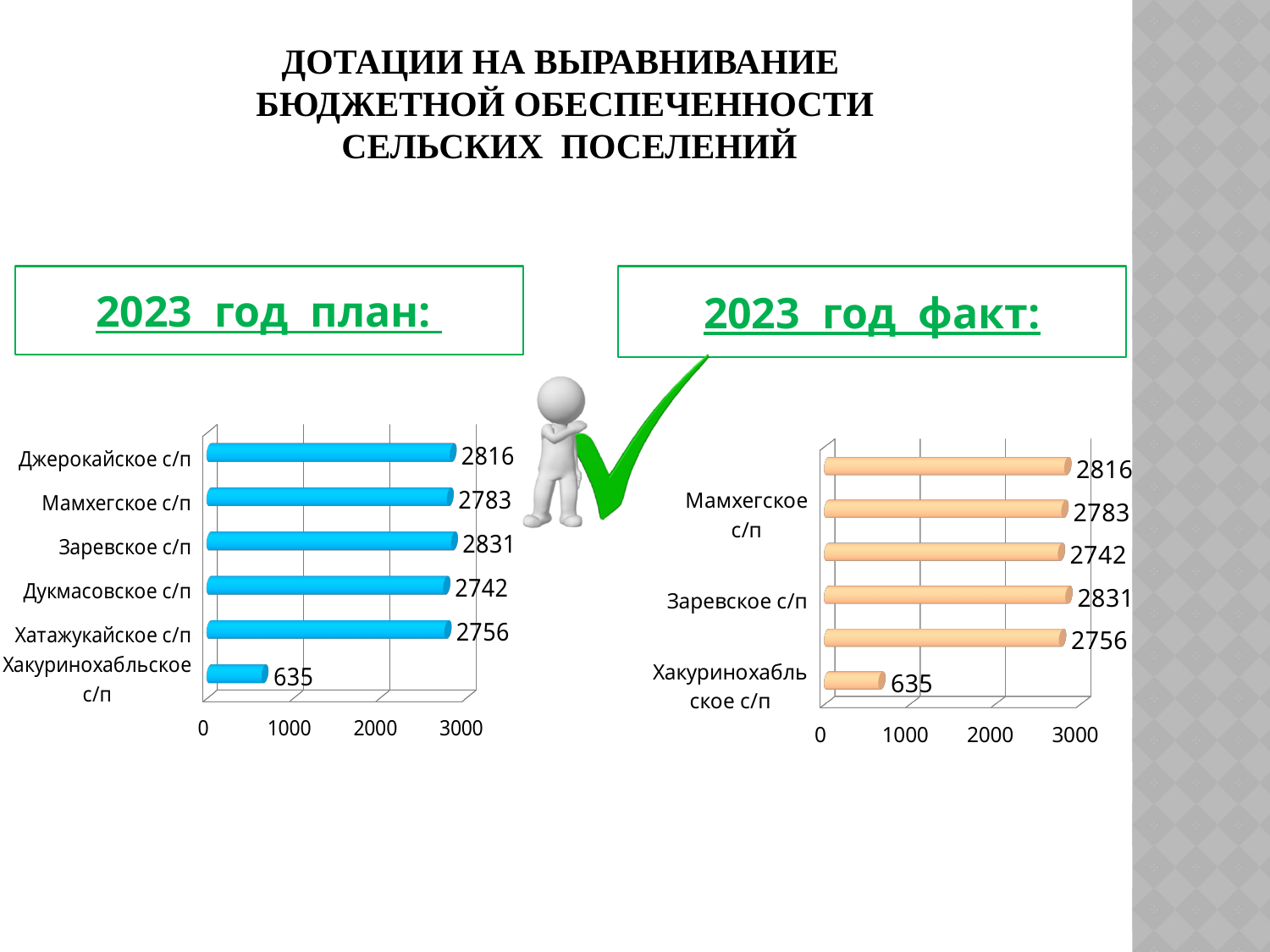
In the '2023 год факт' chart on the right, is the value for Мамхегское с/п greater or less than 2000? greater What kind of chart is the '2023 год план' chart on the left? bar chart In the '2023 год факт' chart on the right, what is the value for Хакуринохабльское с/п? 635 In the '2023 год план' chart, what is the difference between the values for Заревское с/п and Хакуринохабльское с/п? 2196 In the '2023 год план' chart, which category has the lowest value? Хакуринохабльское с/п How many categories are shown in the '2023 год план' chart? 6 In the '2023 год план' chart, what is the value for Дукмасовское с/п? 2742 In the '2023 год план' chart, which category has the highest value? Заревское с/п What colour are the bars in the '2023 год план' chart on the left? blue In the '2023 год факт' chart on the right, what is the value for Заревское с/п? 2831 In the '2023 год план' chart, which is larger: the value for Мамхегское с/п or for Хатажукайское с/п? Мамхегское с/п In the '2023 год план' chart, what is the value for Джерокайское с/п? 2816